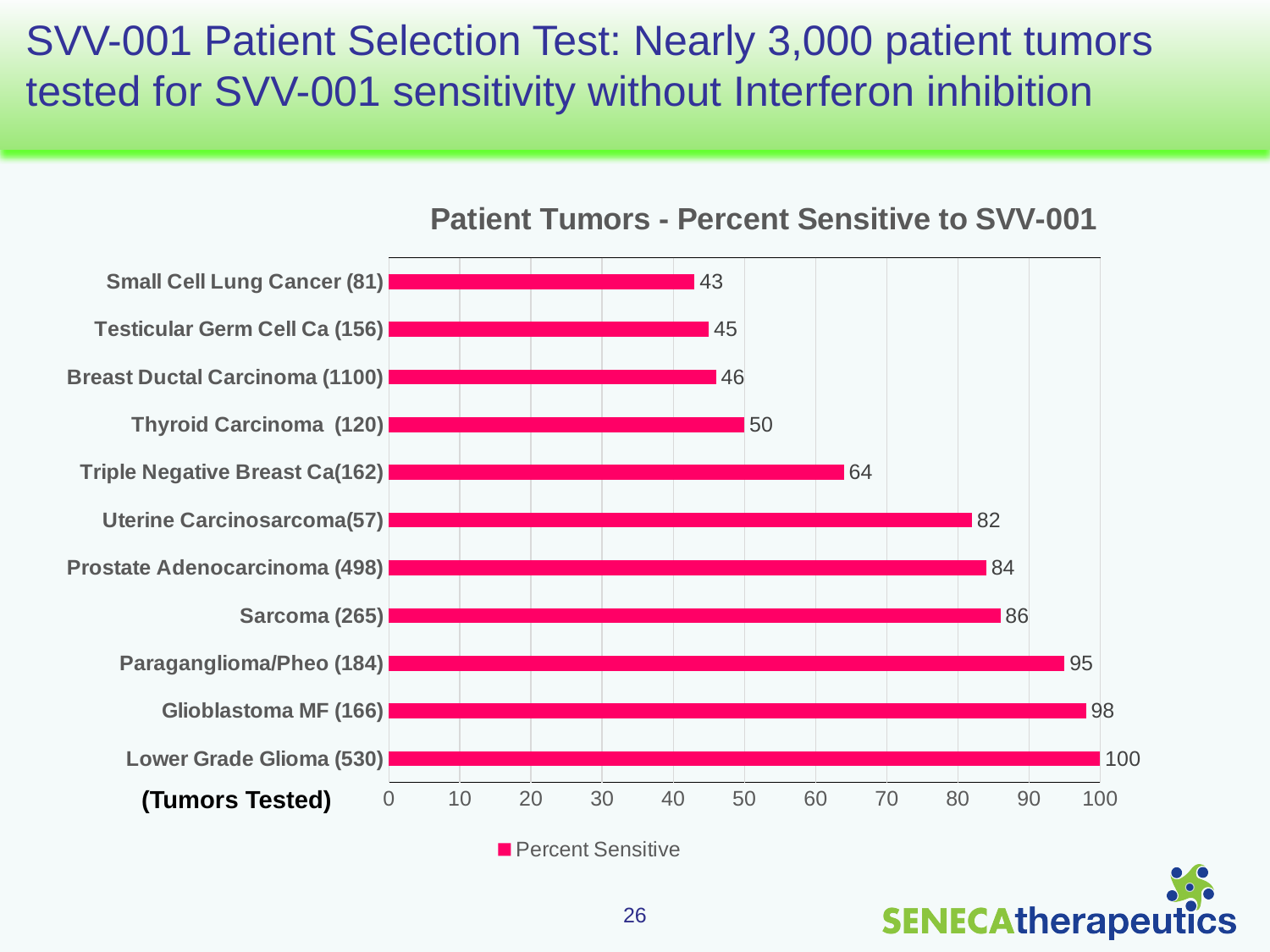
Which category has the lowest percent sensitive value? Small Cell Lung Cancer (81) Is the value for Breast Ductal Carcinoma (1100) greater or less than 50? less Which has a higher percent sensitive value, Paraganglioma/Pheo (184) or Prostate Adenocarcinoma (498)? Paraganglioma/Pheo (184) What is the percent sensitive value for Sarcoma (265)? 86 How many series does the legend list? 1 What is the title of the chart? Patient Tumors - Percent Sensitive to SVV-001 What kind of chart is shown on the slide? bar chart How many tumor categories are shown in the chart? 11 Which category has the highest percent sensitive value? Lower Grade Glioma (530) What is the difference between the percent sensitive values for Glioblastoma MF (166) and Triple Negative Breast Ca(162)? 34 What is the percent sensitive value for Thyroid Carcinoma (120)? 50 What is the percent sensitive value for Uterine Carcinosarcoma(57)? 82